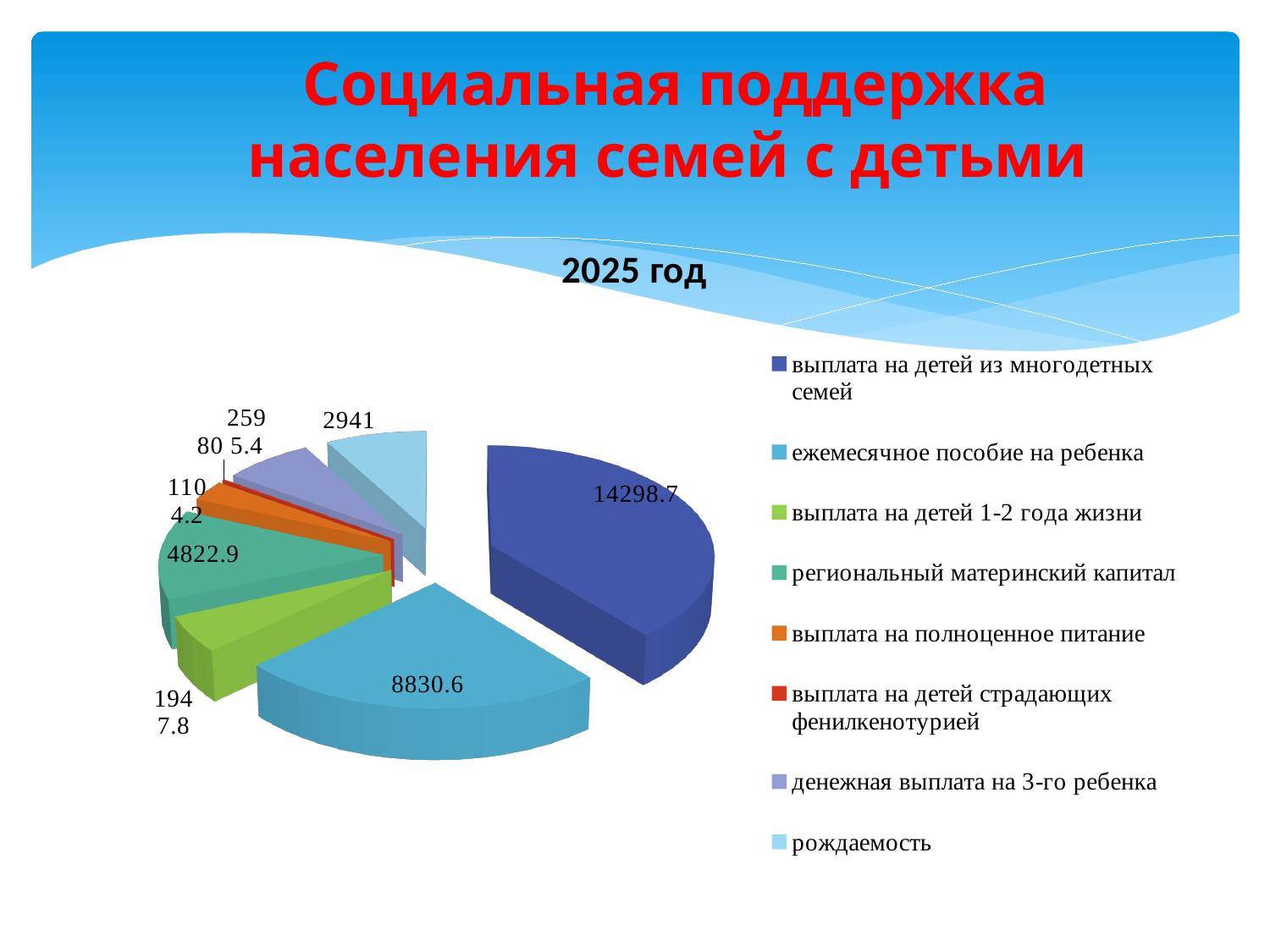
What kind of chart is shown on the slide? pie chart What is the difference between выплата на детей из многодетных семей and ежемесячное пособие на ребенка? 5468.1 What is the difference between ежемесячное пособие на ребенка and региональный материнский капитал? 4007.7 What is the value for ежемесячное пособие на ребенка? 8830.6 Which category has the largest slice of the pie? выплата на детей из многодетных семей How many slices does the pie chart have? 8 What is the value for рождаемость? 2941 How many entries does the legend list? 8 Which is larger: ежемесячное пособие на ребенка or региональный материнский капитал? ежемесячное пособие на ребенка What is the title of the chart? 2025 год What is the value for выплата на детей из многодетных семей? 14298.7 What is the value for региональный материнский капитал? 4822.9